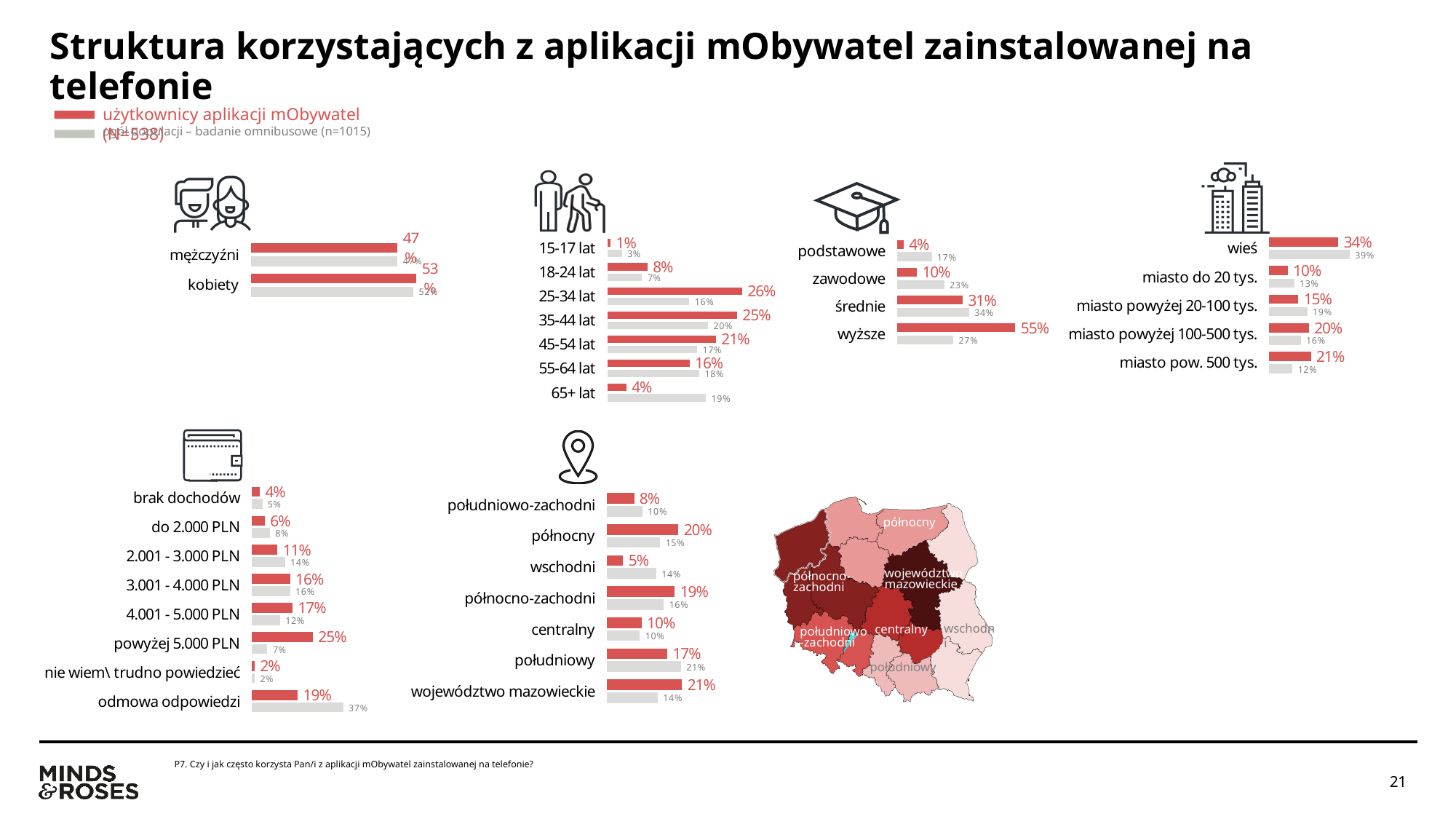
In the region chart (location pin icon), which is larger for 'południowy': the app users' value or the general population value? general population (21%) In the age chart (people icon), which age group has the highest value among mObywatel app users (red bars)? 25-34 lat In the income chart (wallet icon), what is the general population (grey bar) value for 'odmowa odpowiedzi'? 37% In the gender chart, what is the value for 'kobiety' among mObywatel app users (red bar)? 53% In the place of residence chart (buildings icon), what is the difference between the app users' value and the general population value for 'miasto pow. 500 tys.'? 9 percentage points What type of chart is used for the gender breakdown (mężczyźni / kobiety)? Bar chart How many series does the legend list? 2 In the region chart (location pin icon), which region has the lowest value among mObywatel app users (red bars)? wschodni In the age chart (people icon), what is the general population (grey bar) value for '65+ lat'? 19% In the education chart (graduation cap icon), what is the value for 'wyższe' among mObywatel app users (red bars)? 55% In the income chart (wallet icon), which category has the highest value among mObywatel app users (red bars)? powyżej 5.000 PLN How many age groups are shown in the age chart (people icon)? 7